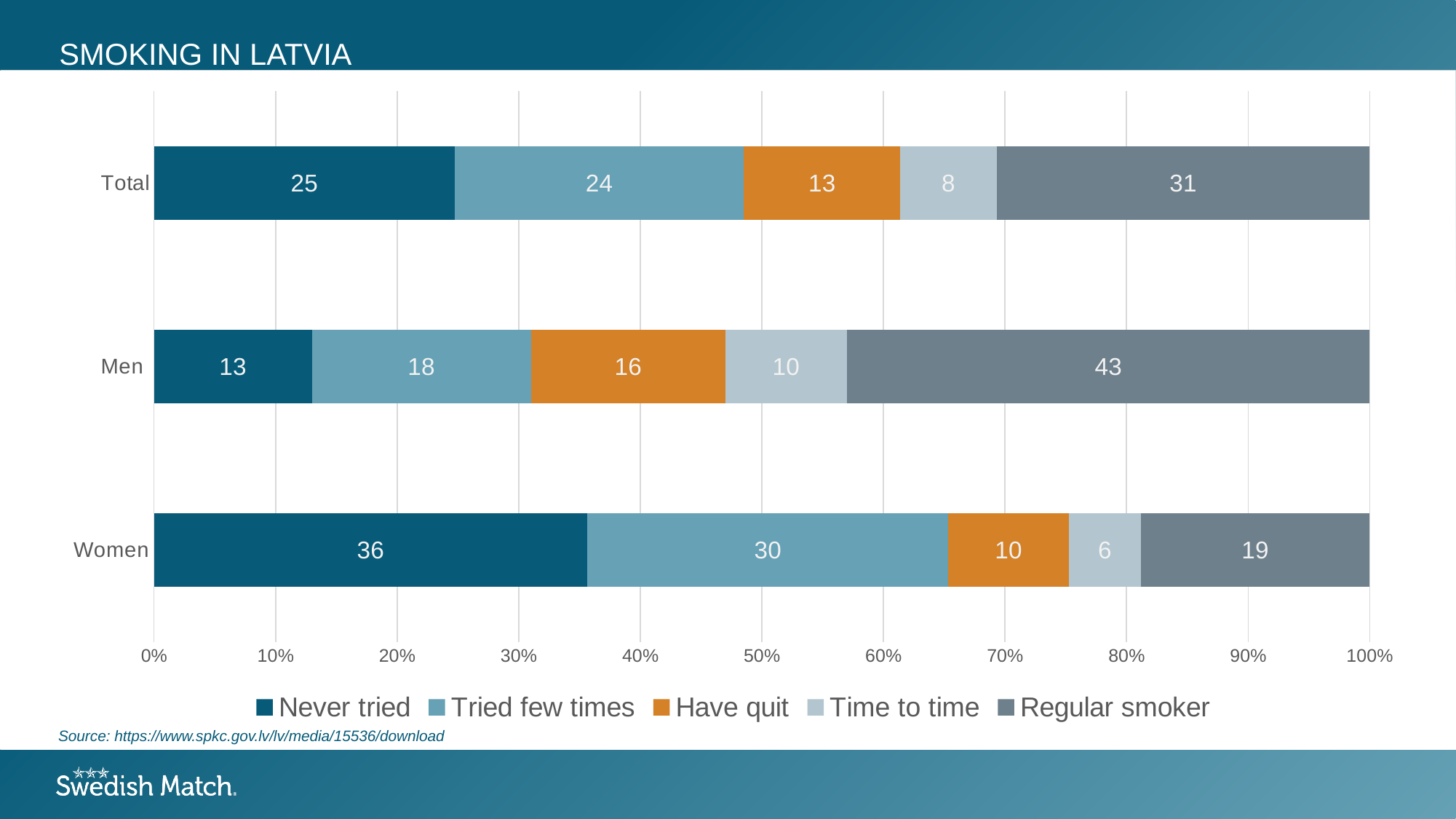
Which category has the highest value for Regular smoker? Men What is the difference between the Regular smoker values for Men and Women? 24 How many series does the legend list? 5 What kind of chart is shown on the slide? Stacked bar chart What is the value for Have quit in the Total bar? 13 What is the value for Regular smoker among Men? 43 Which is larger: Tried few times for Women or Tried few times for Men? Women What is the value for Never tried among Women? 36 What is the value for Time to time among Women? 6 Which category has the lowest value for Never tried? Men How many categories are shown on the y axis? 3 What is the title of the chart? SMOKING IN LATVIA